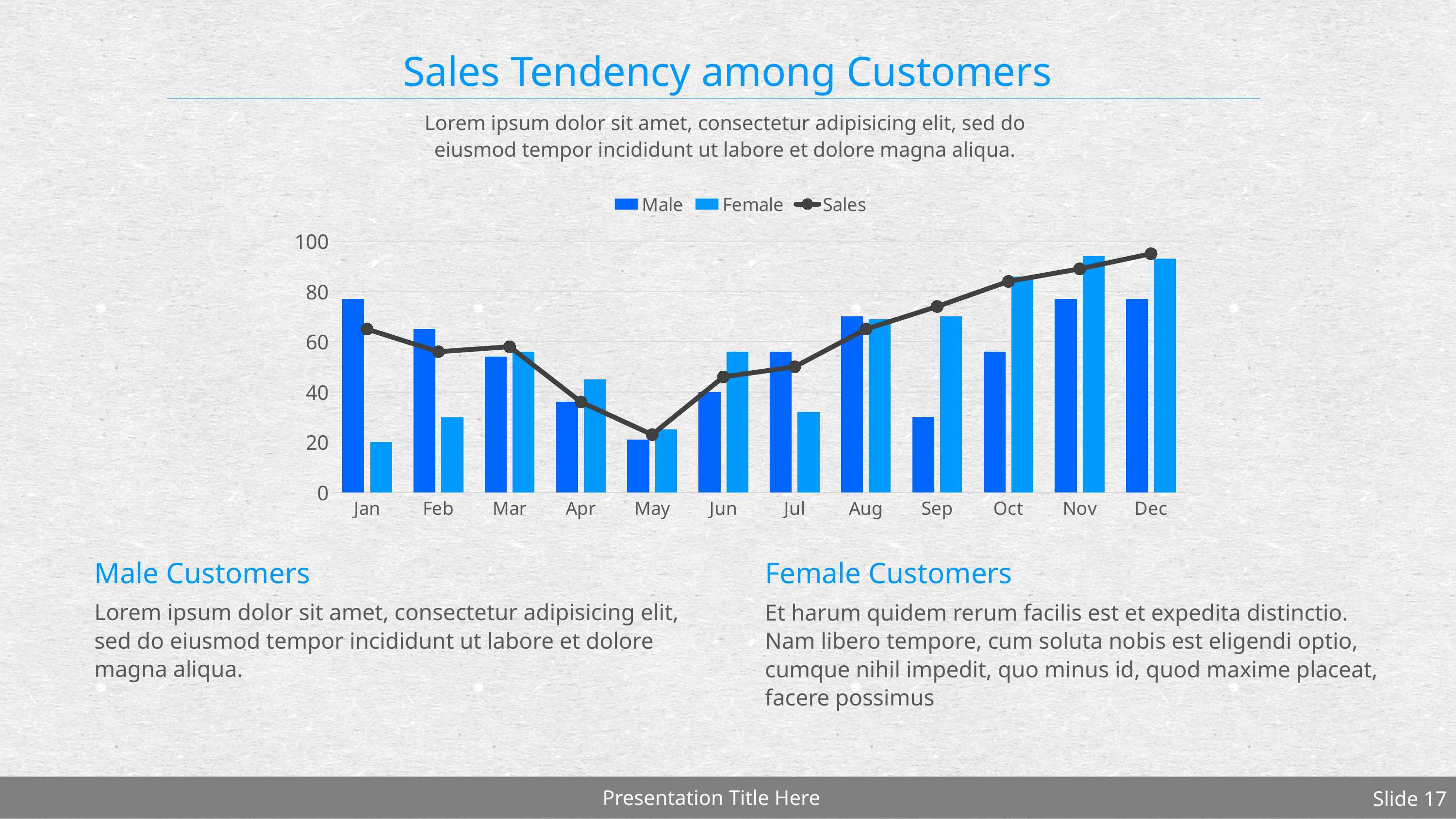
In which month is the Male bar the lowest? May How many months are shown on the x axis of the chart? 12 How many series does the chart legend list? 3 Is the Female value for Nov greater or less than 80? greater Which series is drawn as a line rather than bars? Sales In Sep, which is larger, the Male bar or the Female bar? Female Does the Sales line rise or fall from May to Dec? rise In Jan, which is larger, the Male bar or the Female bar? Male What kind of chart is shown on the slide? A combined bar and line chart In which month is the Sales line at its lowest? May What is the title of the chart on the slide? Sales Tendency among Customers In which month is the Sales line at its highest? Dec